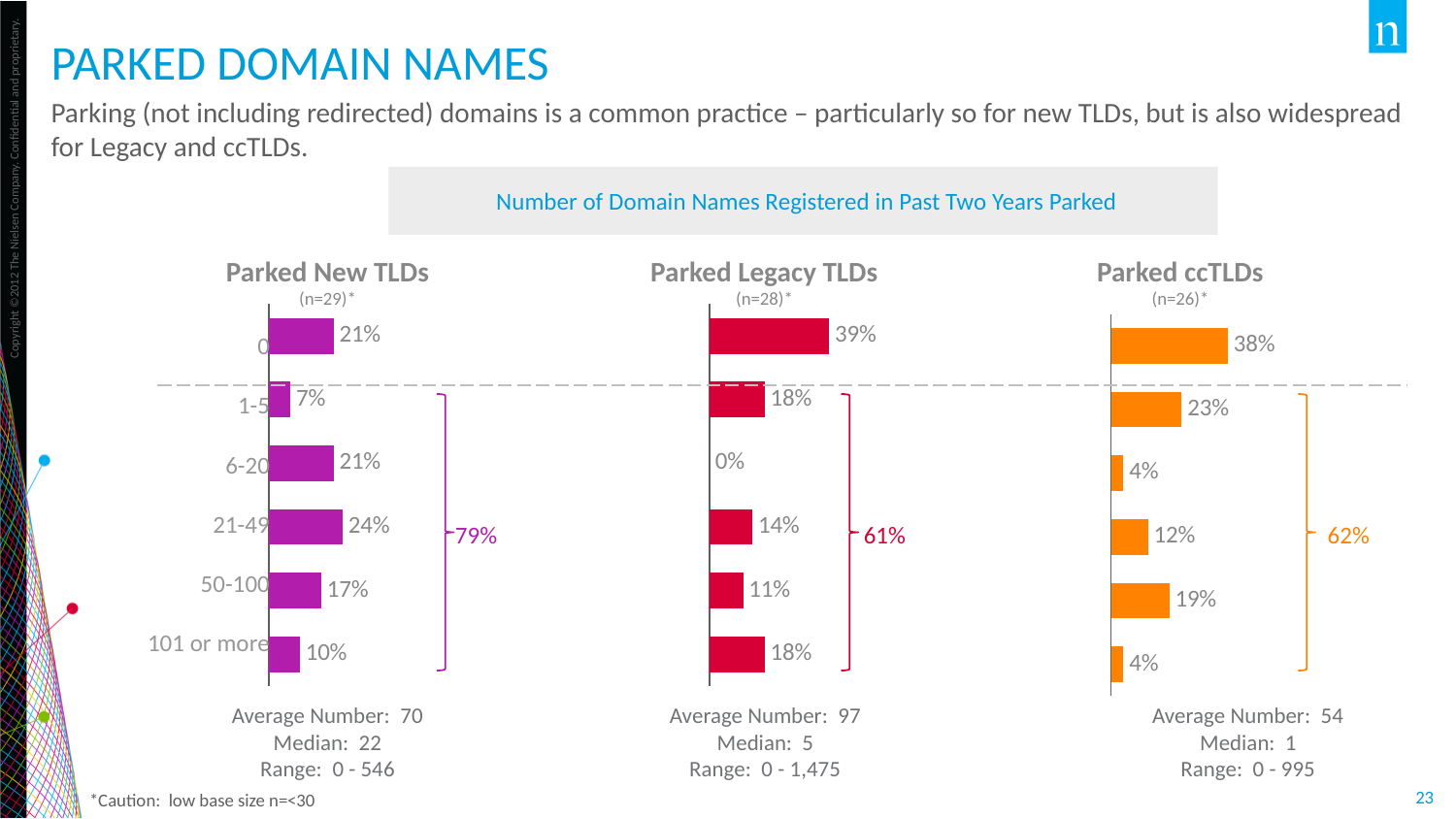
In the Parked Legacy TLDs chart, which is larger: the 1-5 category or the 21-49 category? 1-5 In the Parked Legacy TLDs chart, what percentage is shown for the 0 category? 39% In the Parked New TLDs chart, which category has the highest percentage? 21-49 How many categories are plotted in the Parked New TLDs chart? 6 In the Parked ccTLDs chart, what percentage is shown for the 50-100 category? 19% In the Parked ccTLDs chart, what is the difference between the 0 category and the 1-5 category? 15% In the Parked New TLDs chart, what is the total percentage for the 1-5 through 101 or more categories, as shown by the bracket? 79% What type of chart is used for Parked ccTLDs? Bar chart What is the title shown above the three charts? Number of Domain Names Registered in Past Two Years Parked In the Parked New TLDs chart, what percentage is shown for the 21-49 category? 24% In the Parked Legacy TLDs chart, which category has the lowest percentage? 6-20 In the Parked New TLDs chart, which category has the lowest percentage? 1-5